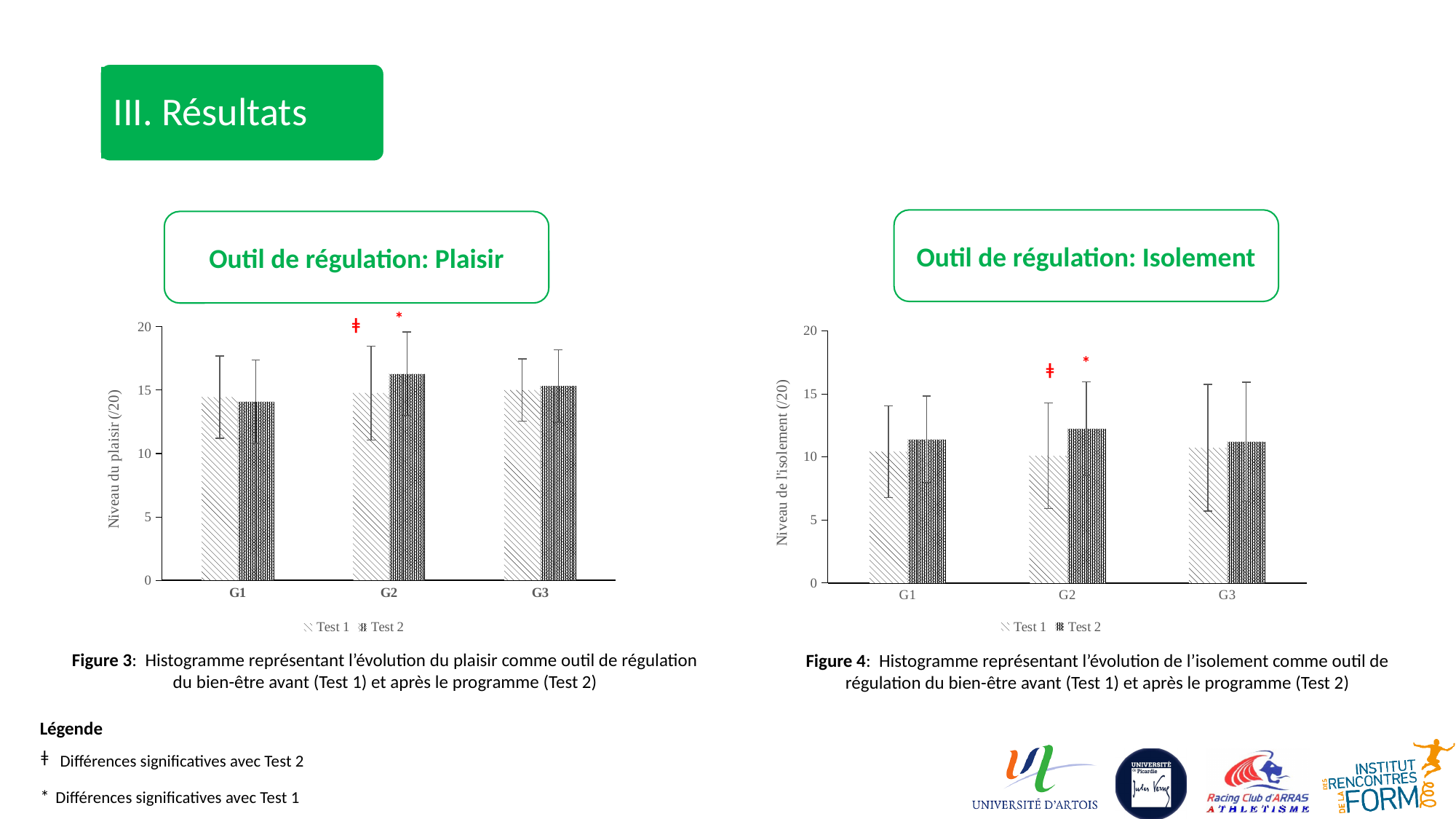
In the 'Outil de régulation: Isolement' chart, which is larger for G2: Test 1 or Test 2? Test 2 In the 'Outil de régulation: Isolement' chart, is the Test 2 value for G2 greater or less than 15? less In the 'Outil de régulation: Plaisir' chart, is the Test 2 value for G1 greater or less than 15? less What kind of chart is the 'Outil de régulation: Plaisir' chart? bar chart What are the two legend entries of the 'Outil de régulation: Plaisir' chart? Test 1 and Test 2 In the 'Outil de régulation: Plaisir' chart, which group has the highest Test 2 value? G2 How many series does the legend of the 'Outil de régulation: Plaisir' chart list? 2 What is the y-axis label of the 'Outil de régulation: Isolement' chart? Niveau de l'isolement (/20) How many categories are shown on the x axis of the 'Outil de régulation: Isolement' chart? 3 In the 'Outil de régulation: Plaisir' chart, is the Test 2 value for G2 greater or less than 15? greater In the 'Outil de régulation: Plaisir' chart, which is larger for G2: Test 1 or Test 2? Test 2